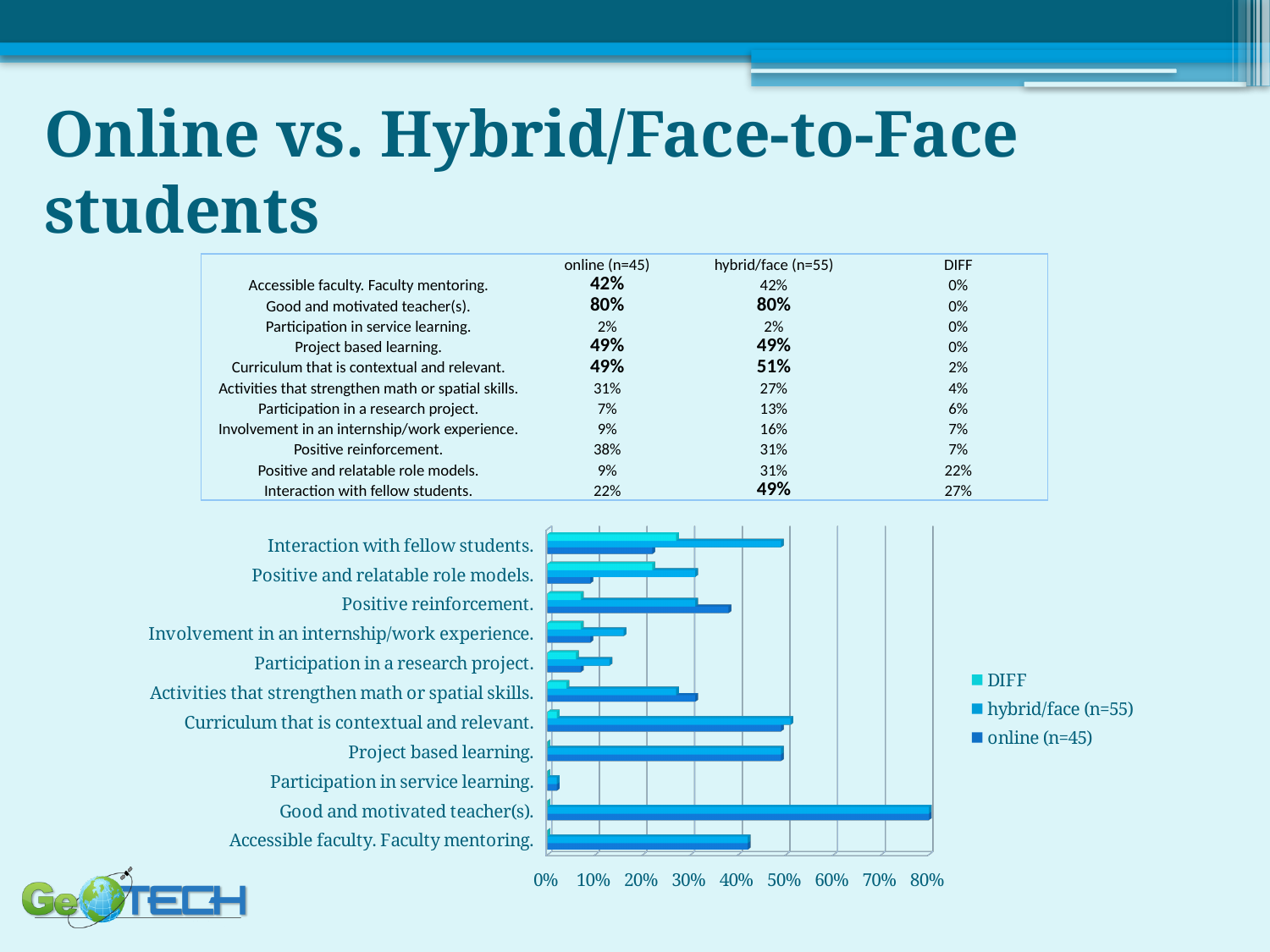
Which category has the highest online (n=45) value? Good and motivated teacher(s). Which category has the lowest hybrid/face (n=55) value? Participation in service learning. What is the difference between the hybrid/face (n=55) and online (n=45) values for Positive reinforcement? 7% Which series is shown in the lightest blue colour in the legend? DIFF What is the online (n=45) value for Good and motivated teacher(s)? 80% How many categories are plotted on the chart? 11 Which is larger for Activities that strengthen math or spatial skills: the online (n=45) value or the hybrid/face (n=55) value? online (n=45) What is the DIFF value for Positive and relatable role models? 22% How many series does the chart legend list? 3 What is the hybrid/face (n=55) value for Interaction with fellow students? 49% Is the online (n=45) value for Accessible faculty. Faculty mentoring greater or less than 30%? greater What kind of chart is shown on the slide? bar chart